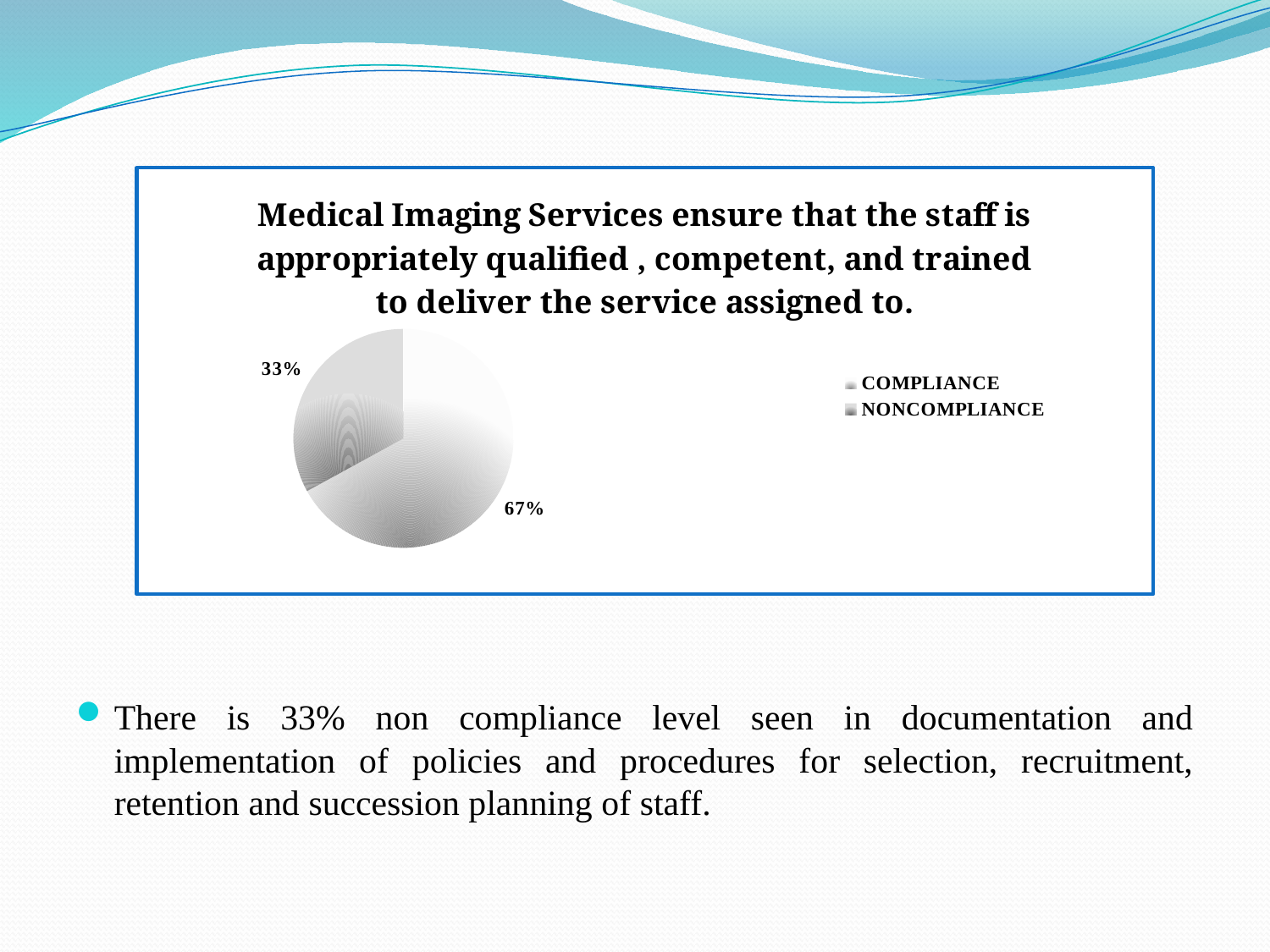
Which category has the largest share of the pie? COMPLIANCE What share of the pie does the NONCOMPLIANCE slice represent? 33% What are the two entries listed in the chart legend? COMPLIANCE and NONCOMPLIANCE Which category has the smallest share of the pie? NONCOMPLIANCE What is the difference in percentage points between the COMPLIANCE and NONCOMPLIANCE slices? 34 How many entries does the chart legend list? 2 What percentage of the pie is labelled for COMPLIANCE? 67% What is the title of the pie chart? Medical Imaging Services ensure that the staff is appropriately qualified , competent, and trained to deliver the service assigned to. What percentage of the pie is labelled for NONCOMPLIANCE? 33% Which is larger, the COMPLIANCE slice or the NONCOMPLIANCE slice? COMPLIANCE How many slices does the pie chart have? 2 What type of chart is shown on the slide? pie chart